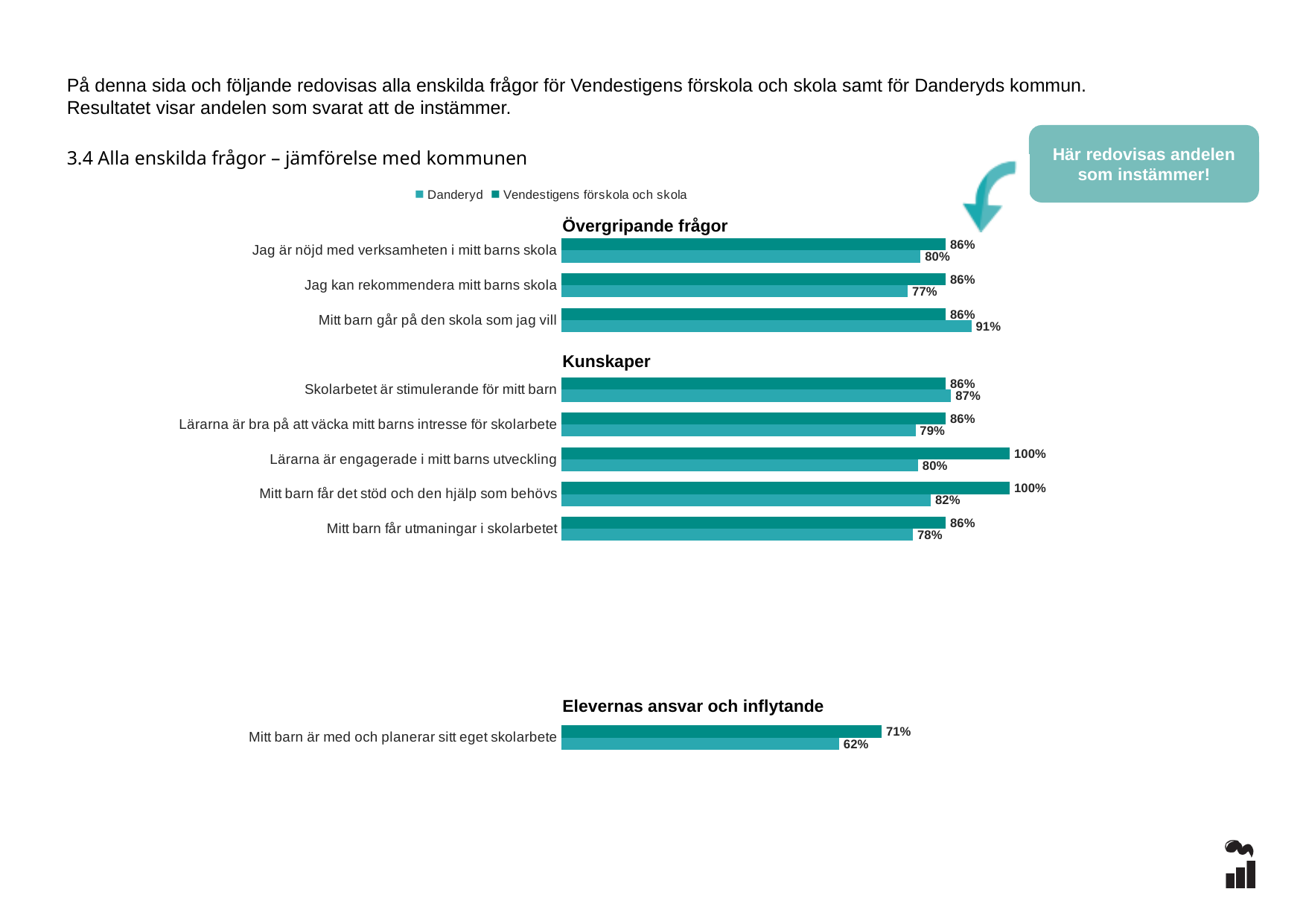
What is the value for Vendestigens förskola och skola for 'Jag är nöjd med verksamheten i mitt barns skola'? 86% What is the value for Danderyd for 'Mitt barn går på den skola som jag vill'? 91% What is the difference between Vendestigens förskola och skola and Danderyd for 'Lärarna är engagerade i mitt barns utveckling'? 20% What is the value for Danderyd for 'Jag kan rekommendera mitt barns skola'? 77% How many questions (categories) are plotted in the chart? 9 What is the difference between Danderyd and Vendestigens förskola och skola for 'Mitt barn får utmaningar i skolarbetet'? 8% Which series is shown in the lighter teal colour in the legend? Danderyd Which question has the lowest value for Danderyd? Mitt barn är med och planerar sitt eget skolarbete What kind of chart is shown on the slide? bar chart How many series does the legend list? 2 What is the value for Vendestigens förskola och skola for 'Mitt barn är med och planerar sitt eget skolarbete'? 71% For 'Mitt barn får det stöd och den hjälp som behövs', which is larger: Vendestigens förskola och skola or Danderyd? Vendestigens förskola och skola